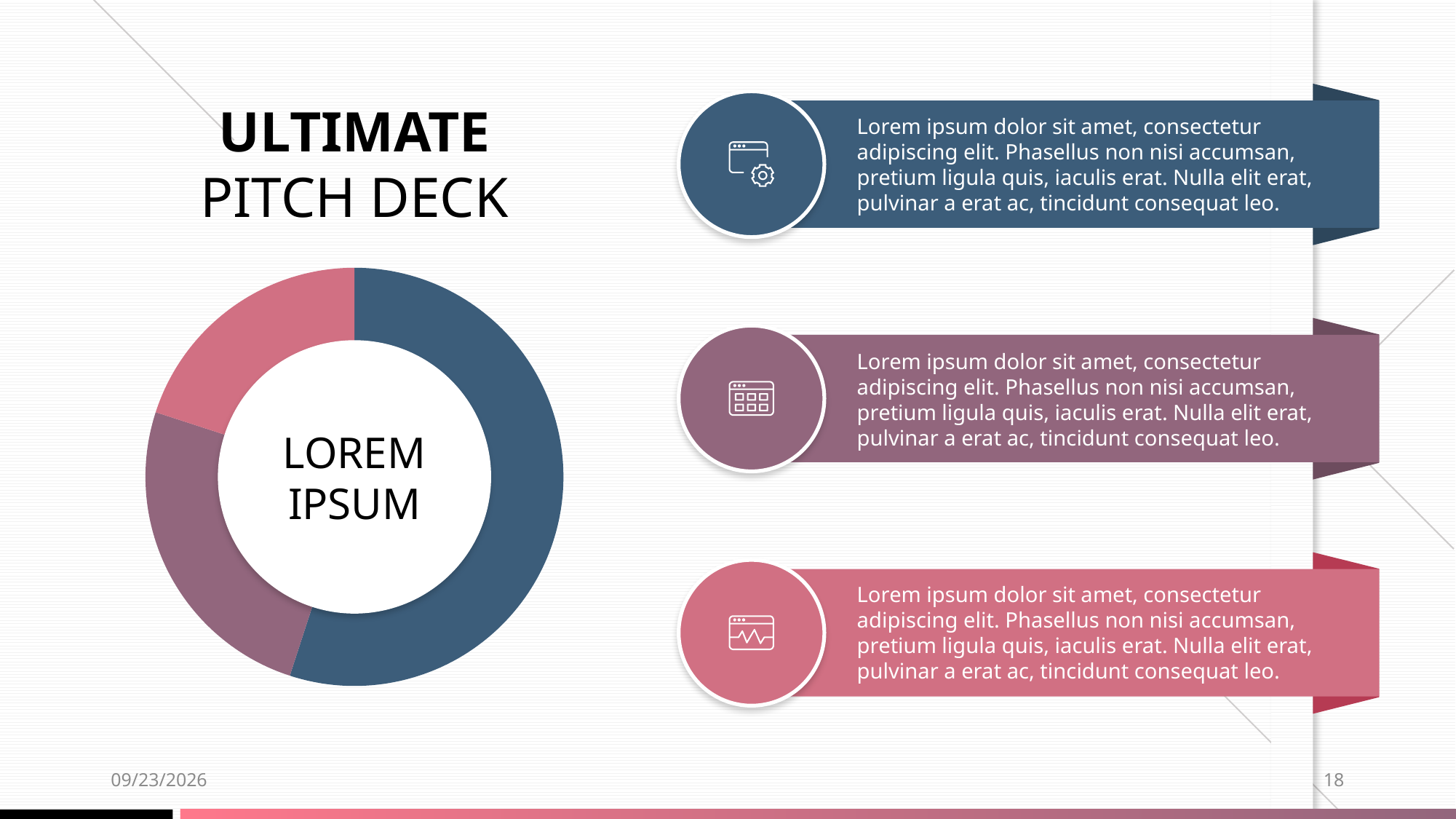
Does the donut chart display a legend? No Which is larger in the donut chart, the blue slice or the pink slice? The blue slice Which is larger in the donut chart, the blue slice or the mauve (purple) slice? The blue slice How many slices does the donut chart have? 3 What kind of chart is shown on the left of the slide? Donut chart Which colour slice is the largest in the donut chart? Blue Does the blue slice take up more or less than half of the donut chart? More What text is written in the centre of the donut chart? LOREM IPSUM